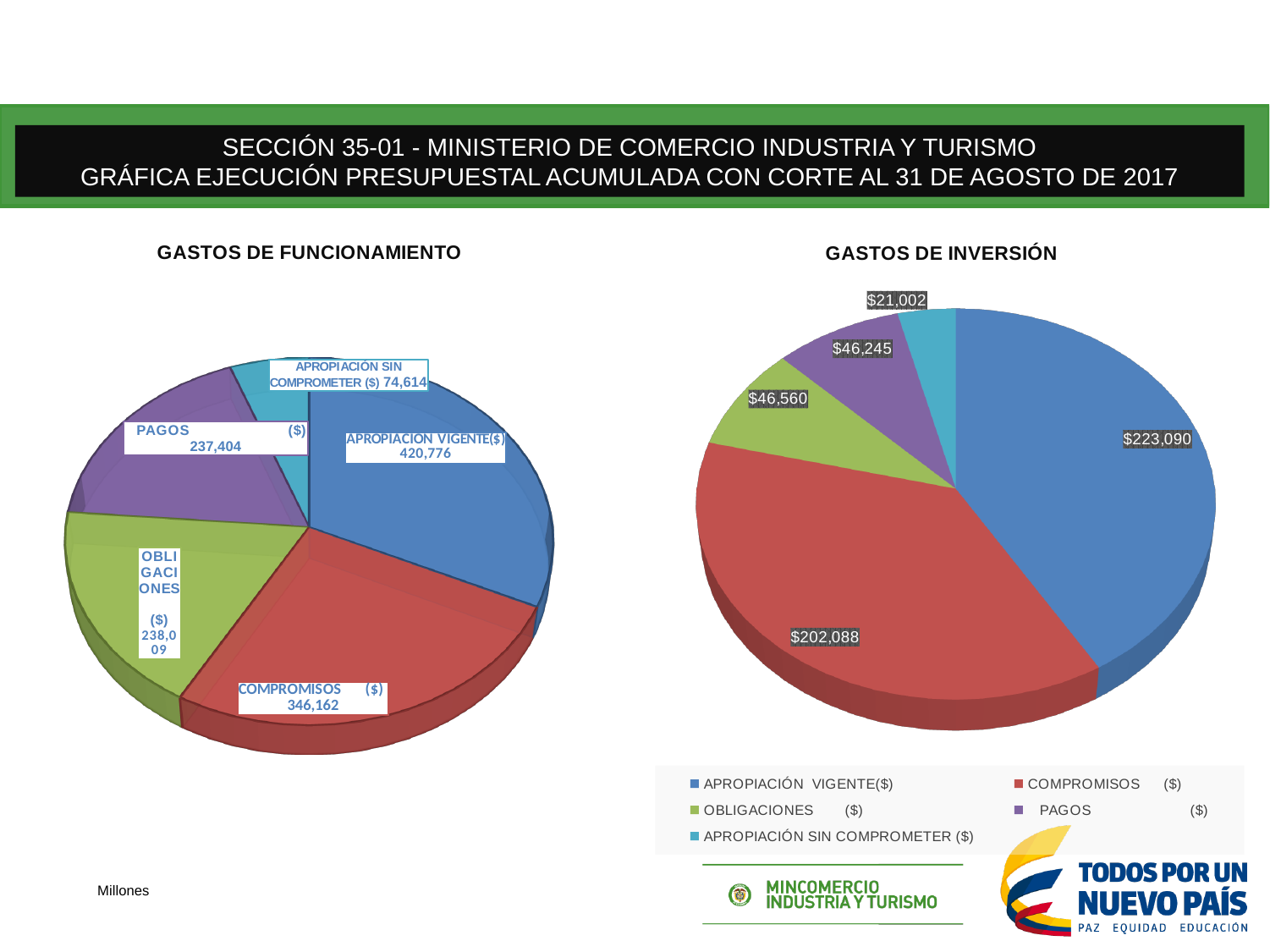
In the GASTOS DE INVERSIÓN chart, what is the difference between APROPIACIÓN VIGENTE and COMPROMISOS? $21,002 In the GASTOS DE FUNCIONAMIENTO chart, what is the value for APROPIACIÓN SIN COMPROMETER? 74,614 In the GASTOS DE FUNCIONAMIENTO chart, what is the value for APROPIACIÓN VIGENTE? 420,776 In the GASTOS DE INVERSIÓN chart, what is the value of the largest slice? $223,090 In the GASTOS DE FUNCIONAMIENTO chart, what is the difference between APROPIACIÓN VIGENTE and COMPROMISOS? 74,614 In the GASTOS DE FUNCIONAMIENTO chart, what is the value for COMPROMISOS? 346,162 In the GASTOS DE INVERSIÓN chart, what is the value for COMPROMISOS? $202,088 How many slices does the GASTOS DE INVERSIÓN pie chart have? 5 In the GASTOS DE FUNCIONAMIENTO chart, which is larger, OBLIGACIONES or PAGOS? OBLIGACIONES In the GASTOS DE FUNCIONAMIENTO chart, which category has the smallest value? APROPIACIÓN SIN COMPROMETER How many entries does the legend of the GASTOS DE INVERSIÓN chart list? 5 What kind of chart is the GASTOS DE FUNCIONAMIENTO chart? Pie chart